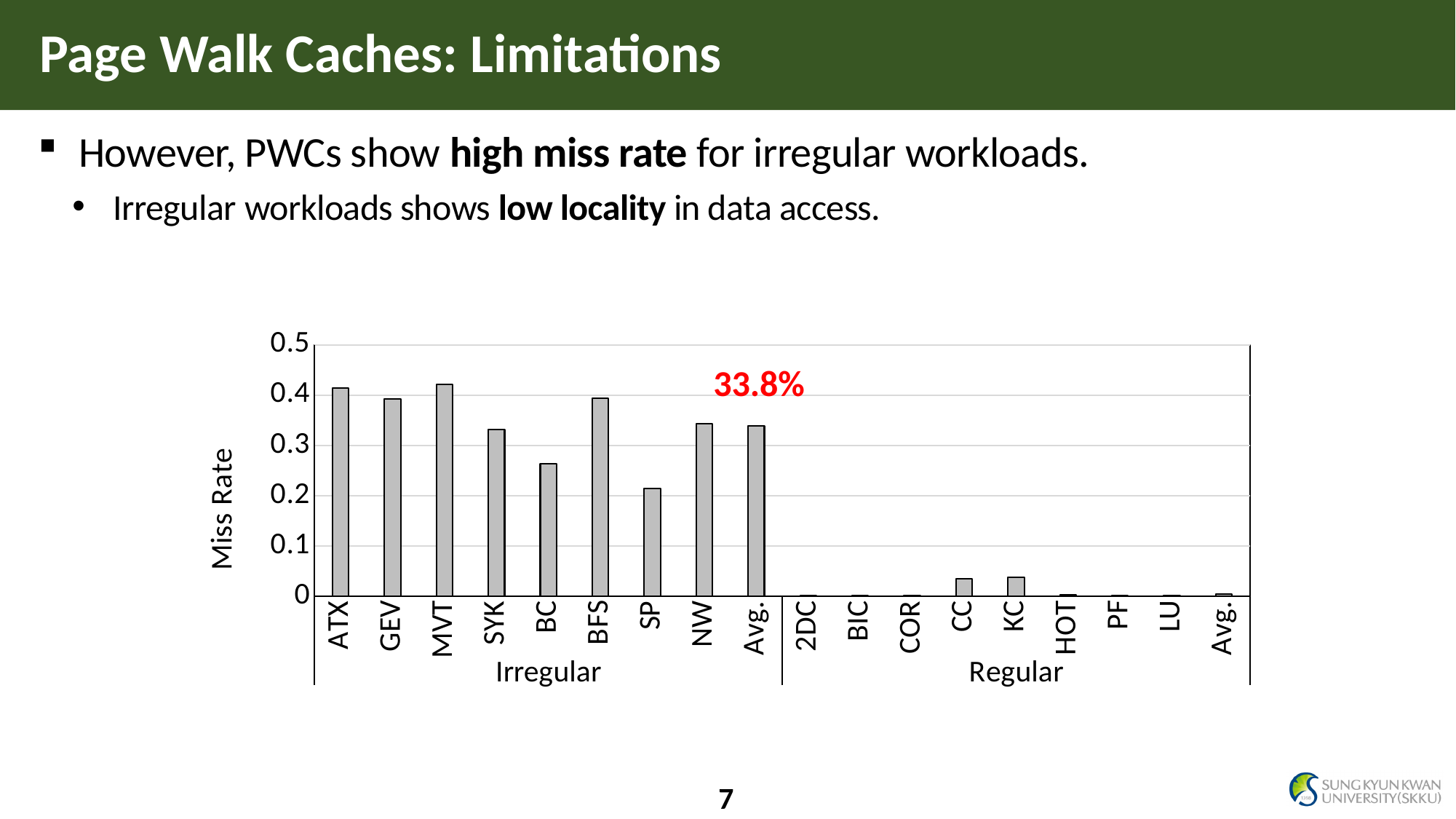
How many bars are in the Irregular group? 9 Is the miss rate for MVT greater or less than 0.4? greater What value is printed above the Avg. bar of the Irregular group? 33.8% Is the miss rate for CC greater or less than 0.1? less Which has a higher miss rate, BFS or BC? BFS What kind of chart is shown on the slide? bar chart What is the label on the y-axis of the chart? Miss Rate Which workload in the Irregular group has the lowest miss rate? SP What are the two group labels shown under the x-axis? Irregular and Regular Which has a higher miss rate, SP or NW? NW Is the miss rate for BC greater or less than 0.3? less How many categories are plotted in total across both groups? 18